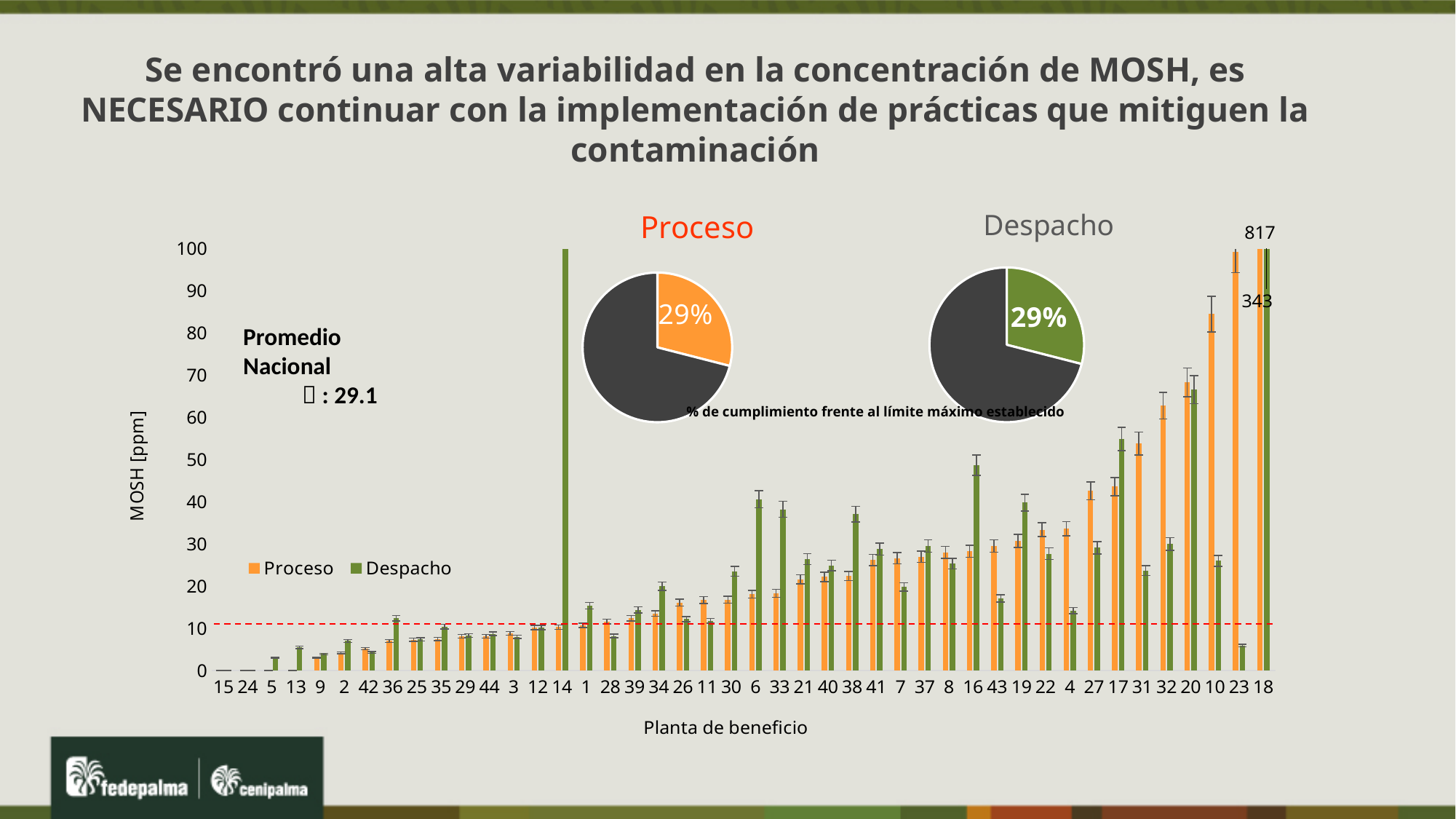
What is the largest data label printed on the bar chart, above plant 18? 817 What kind of chart is the large chart at the bottom of the slide? bar chart In the bar chart, is the Despacho value for plant 6 greater or less than 30? greater In the bar chart, is the Proceso value for plant 20 greater or less than 60? greater In the 'Despacho' pie chart, what share is shown for the green slice? 29% In the bar chart, which series has the larger value for plant 10, Proceso or Despacho? Proceso How many series does the legend of the bar chart list? 2 In the 'Proceso' pie chart, what share is shown for the orange slice? 29% In the bar chart, is the Despacho value for plant 23 greater or less than 10? less How many plants (categories) are shown on the x axis of the bar chart? 44 What is the label of the y axis of the bar chart? MOSH [ppm]